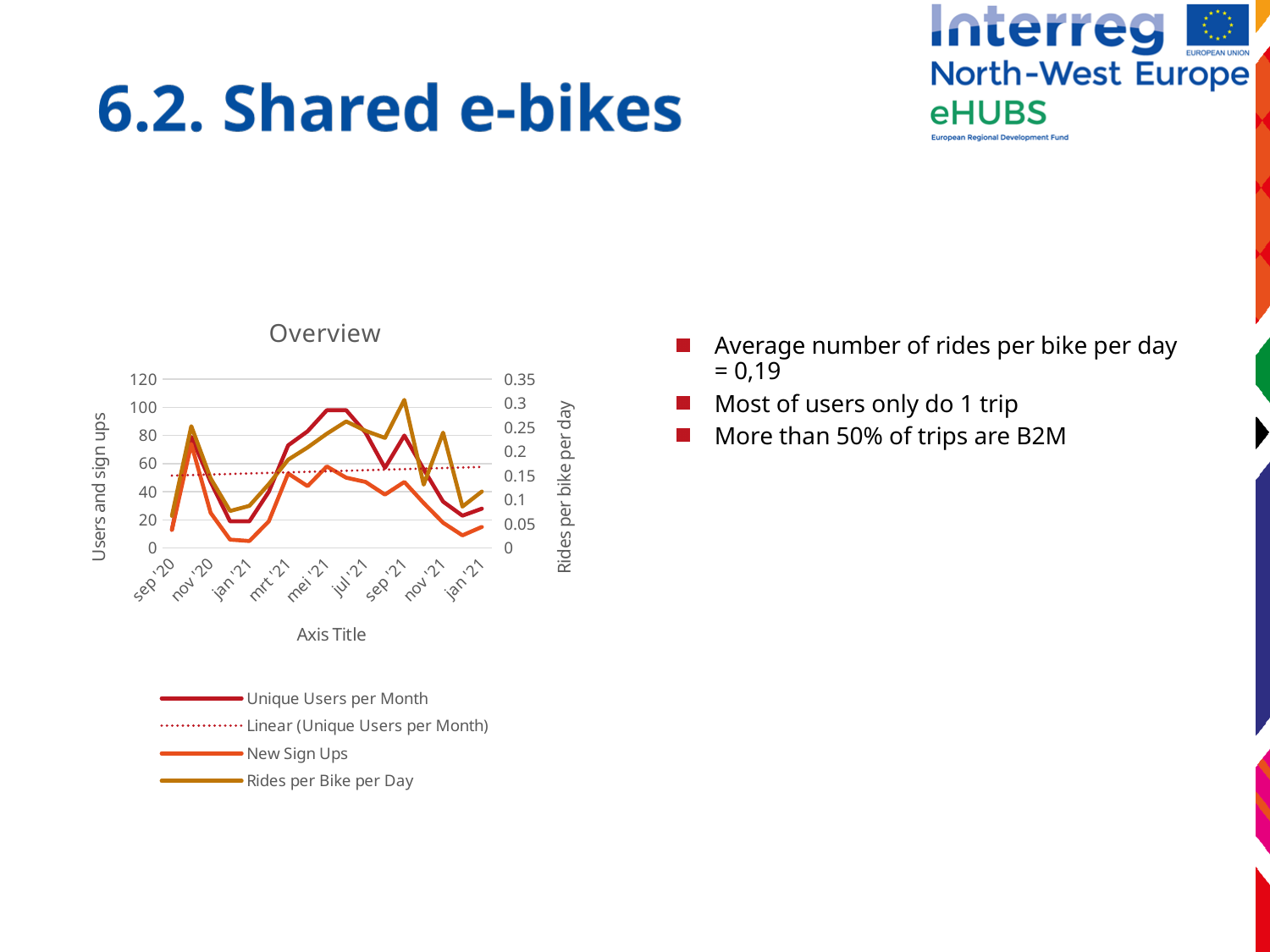
Is the value of Unique Users per Month at mei '21 greater or less than 80? greater Does the Linear (Unique Users per Month) trend line rise or fall from left to right? Rise Is the value of New Sign Ups at jan '21 (the first jan '21) greater or less than 20? less Is the value of New Sign Ups at mei '21 greater or less than 40? greater At which x-axis label does Rides per Bike per Day reach its highest value? sep '21 What is the title of the chart? Overview What is the title of the left vertical axis? Users and sign ups At mei '21, which is larger: Unique Users per Month or New Sign Ups? Unique Users per Month How many series does the chart legend list? 4 Does the Unique Users per Month line rise or fall between sep '20 and nov '20? Rise What kind of chart is shown on the slide? Line chart